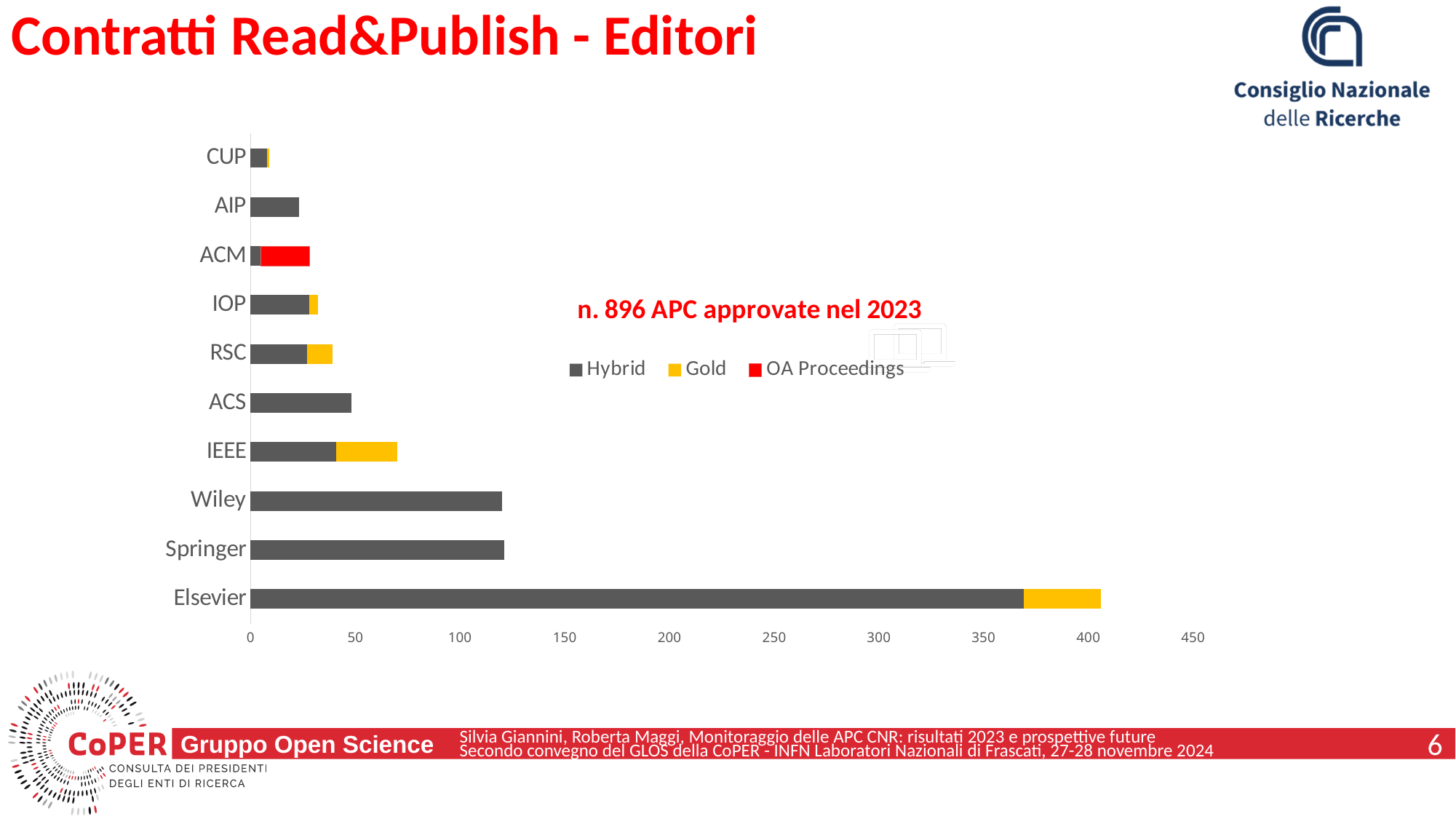
Is the total value for Wiley greater or less than 100? greater Is the total value for ACM greater or less than 50? less Which bar is longer, Elsevier or Wiley? Elsevier Which bar is longer, IEEE or ACS? IEEE Which publisher is the only one with an OA Proceedings segment in its bar? ACM Which publisher has the shortest bar on the chart? CUP What are the three series named in the chart legend? Hybrid, Gold, OA Proceedings Which publisher has the longest bar on the chart? Elsevier What kind of chart is shown on the slide? bar chart Is the Hybrid value for Elsevier greater or less than 350? greater How many publishers are listed on the chart's vertical axis? 10 How many series does the chart legend list? 3